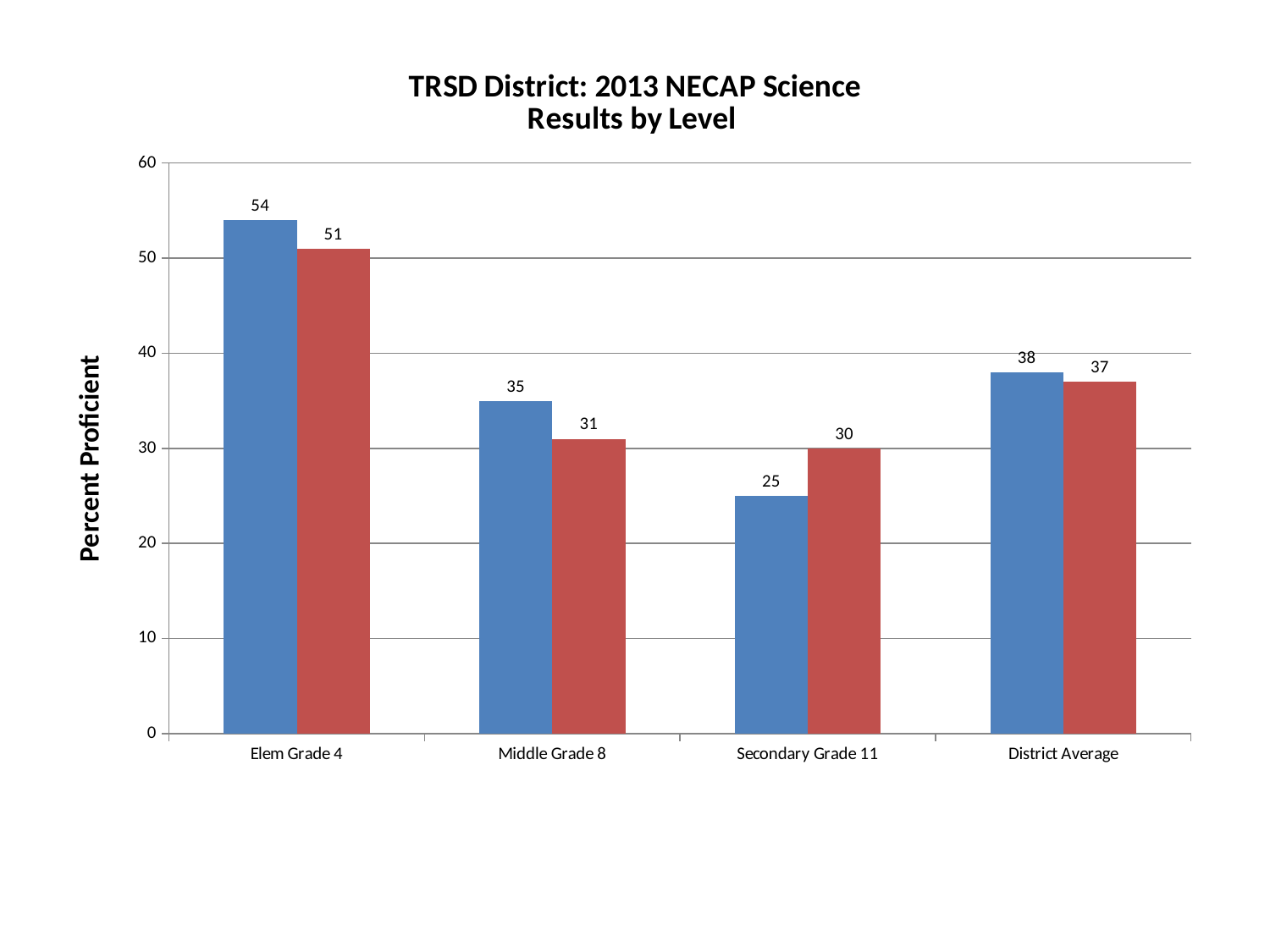
What is the difference between the blue and red bars for Elem Grade 4? 3 What is the value of the blue bar for District Average? 38 Which category has the lowest red bar? Secondary Grade 11 Which category has the highest blue bar? Elem Grade 4 What is the difference between the blue bar for Elem Grade 4 and the blue bar for Secondary Grade 11? 29 What kind of chart is shown on the slide? bar chart For Secondary Grade 11, which is larger, the blue bar or the red bar? the red bar What is the value of the blue bar for Elem Grade 4? 54 What is the value of the red bar for Secondary Grade 11? 30 How many categories are shown on the x axis? 4 What is the value of the red bar for Middle Grade 8? 31 What is the title of the chart? TRSD District: 2013 NECAP Science Results by Level